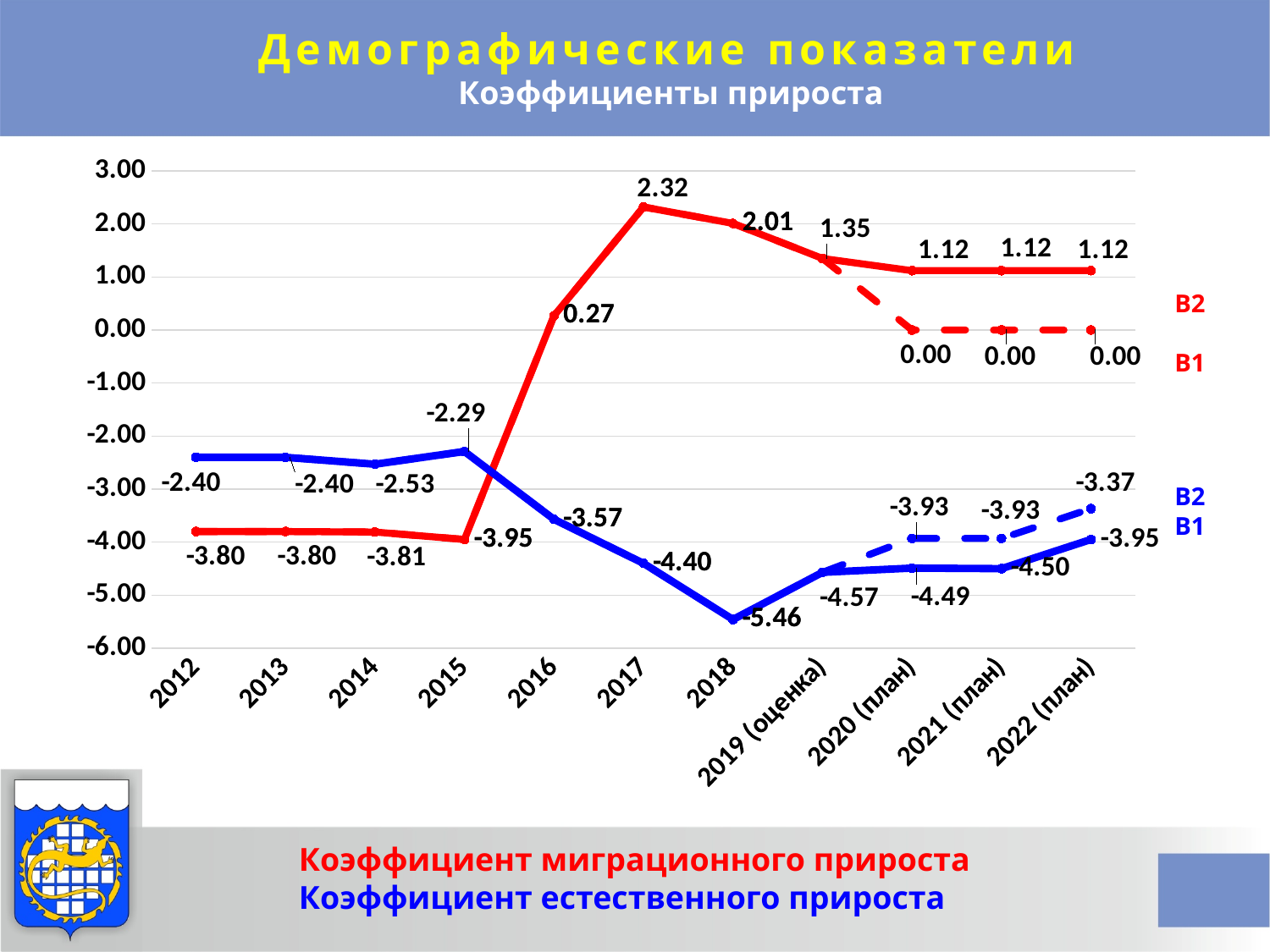
What is the migration growth coefficient (red line) for 2017? 2.32 What is the difference between the migration growth coefficient in 2017 and in 2018? 0.31 What is the migration growth coefficient (red line) for 2016? 0.27 What is the natural growth coefficient (blue line) for 2018? -5.46 What type of chart is shown on the slide? Line chart Which is larger in 2019 (оценка): the migration growth coefficient or the natural growth coefficient? Migration growth coefficient (1.35) How many years (x-axis categories) are shown on the chart? 11 What is the migration growth coefficient under scenario B1 for 2020 (план)? 0.00 In which year does the migration growth coefficient (red line) reach its highest value? 2017 What is the natural growth coefficient (blue line) for 2015? -2.29 What is the natural growth coefficient under scenario B2 for 2022 (план)? -3.37 In which year is the natural growth coefficient (blue line) at its lowest? 2018